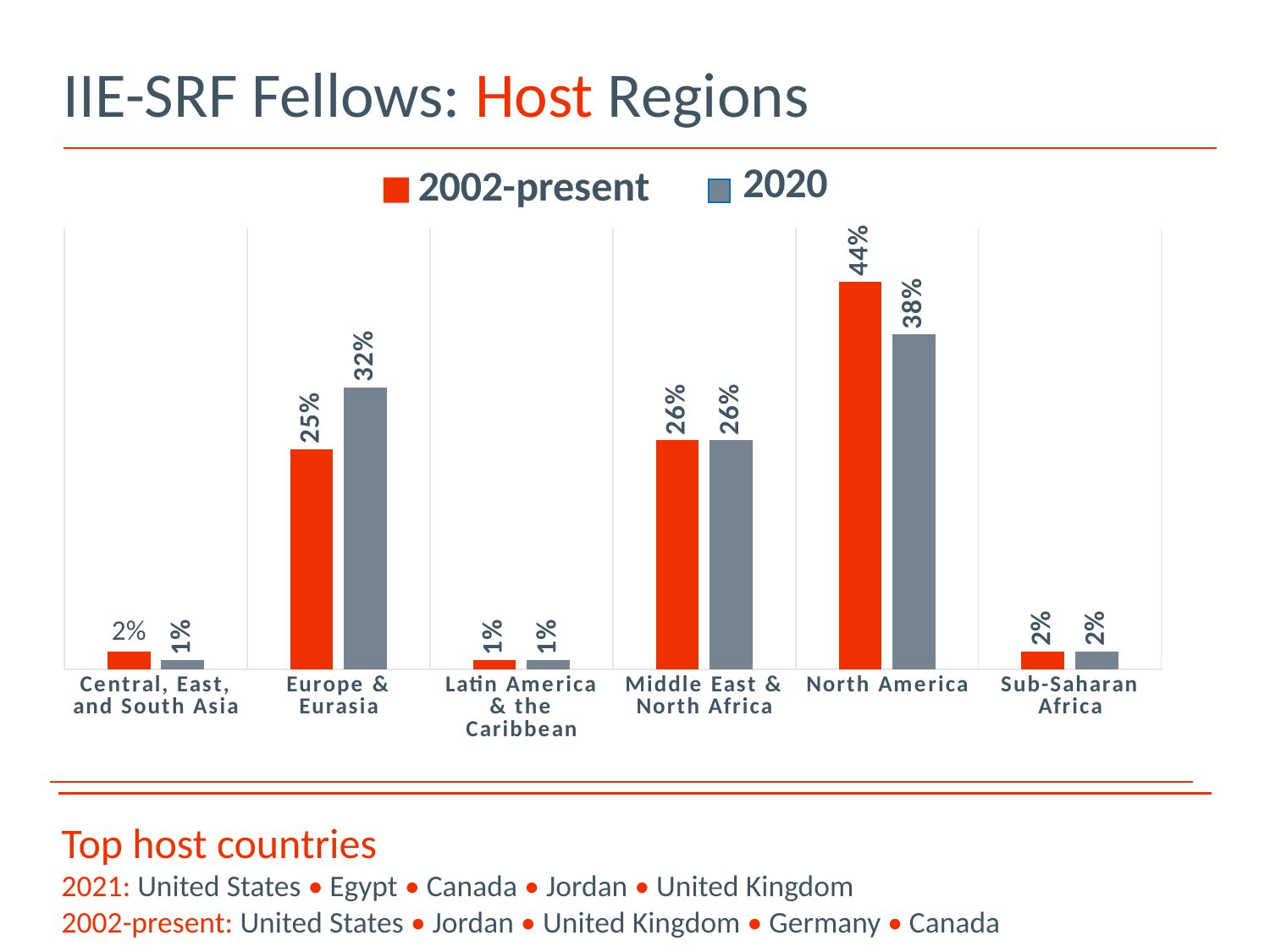
How many series does the legend list? 2 What is the 2002-present value for Central, East, and South Asia? 2% What is the 2002-present value for North America? 44% What is the difference between the 2020 and 2002-present values for Europe & Eurasia? 7% What kind of chart is shown on the slide? Bar chart Which region has the highest 2020 value? North America Which is larger for Europe & Eurasia: the 2002-present value or the 2020 value? 2020 What is the 2020 value for Europe & Eurasia? 32% What is the difference between the 2002-present and 2020 values for North America? 6% How many regions are shown on the x axis? 6 What is the 2020 value for Middle East & North Africa? 26% Which region has the lowest 2002-present value? Latin America & the Caribbean